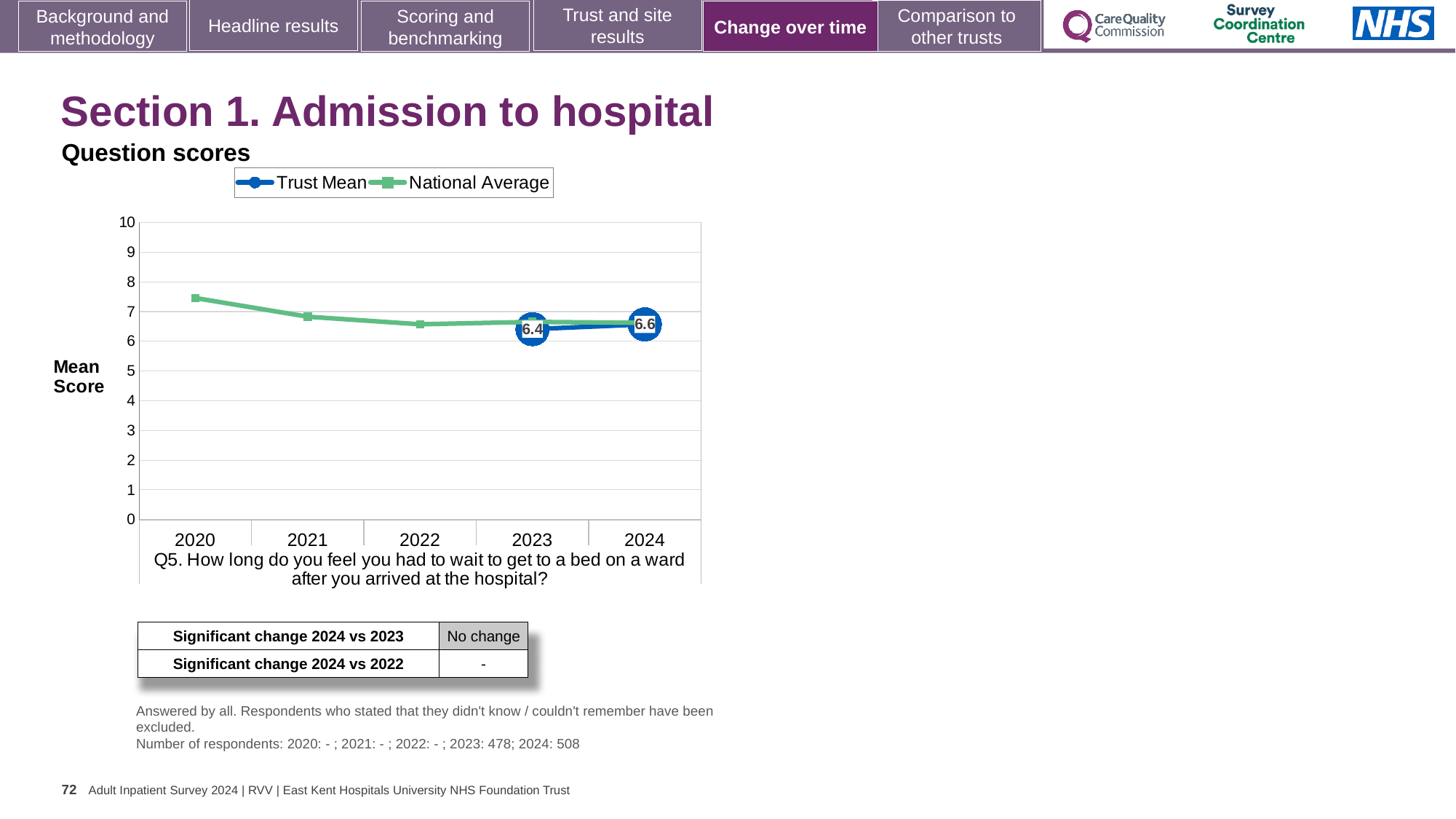
Does the National Average rise or fall from 2020 to 2022? Fall What is the label on the y axis of the chart? Mean Score By how much did the Trust Mean change from 2023 to 2024? 0.2 Is the National Average value for 2022 greater or less than 7? less Is the National Average value for 2020 greater or less than 7? greater How many series does the legend list? 2 What is the Trust Mean value for 2024? 6.6 Which year has the higher Trust Mean, 2023 or 2024? 2024 In which year is the National Average highest? 2020 What is the Trust Mean value for 2023? 6.4 What kind of chart is shown on the slide? Line chart How many years are shown on the x axis? 5